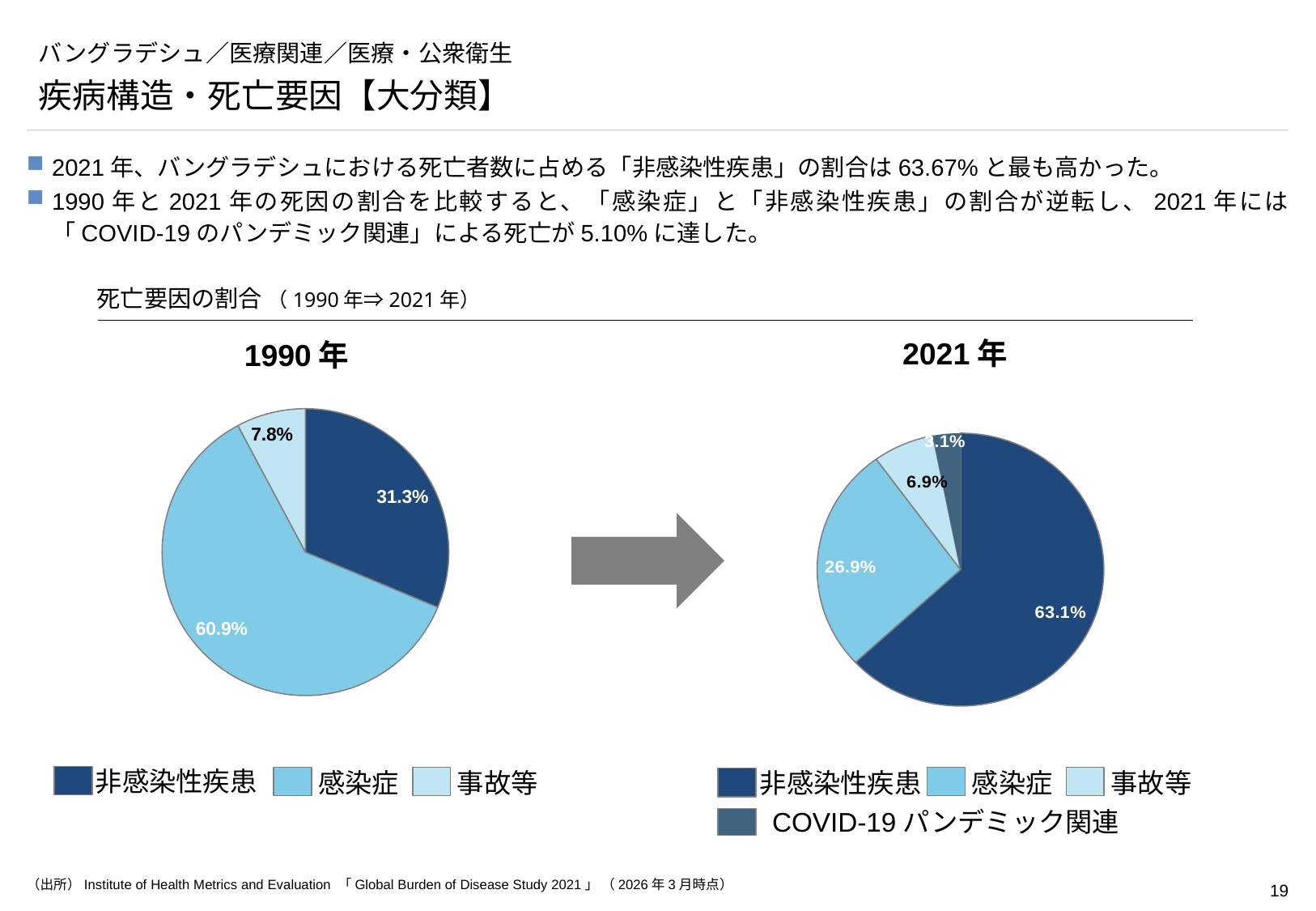
In the 1990年 pie chart, what share of deaths is attributed to 感染症? 60.9% In the 2021年 pie chart, which category has the smallest share? COVID-19 パンデミック関連 In the 1990年 pie chart, what share of deaths is attributed to 事故等? 7.8% In the 2021年 pie chart, what share of deaths is attributed to 感染症? 26.9% In the 1990年 pie chart, which is larger: the share of 非感染性疾患 or the share of 感染症? 感染症 In the 2021年 pie chart, what share of deaths is attributed to 非感染性疾患? 63.1% In the 1990年 pie chart, what share of deaths is attributed to 非感染性疾患? 31.3% What type of chart is used to show the 1990年 and 2021年 data? Pie chart How many categories does the legend of the 2021年 pie chart list? 4 In the 1990年 pie chart, which category has the largest share? 感染症 In the 2021年 pie chart, what is the difference between the shares of 非感染性疾患 and 感染症? 36.2% In the 2021年 pie chart, what share of deaths is attributed to 事故等? 6.9%